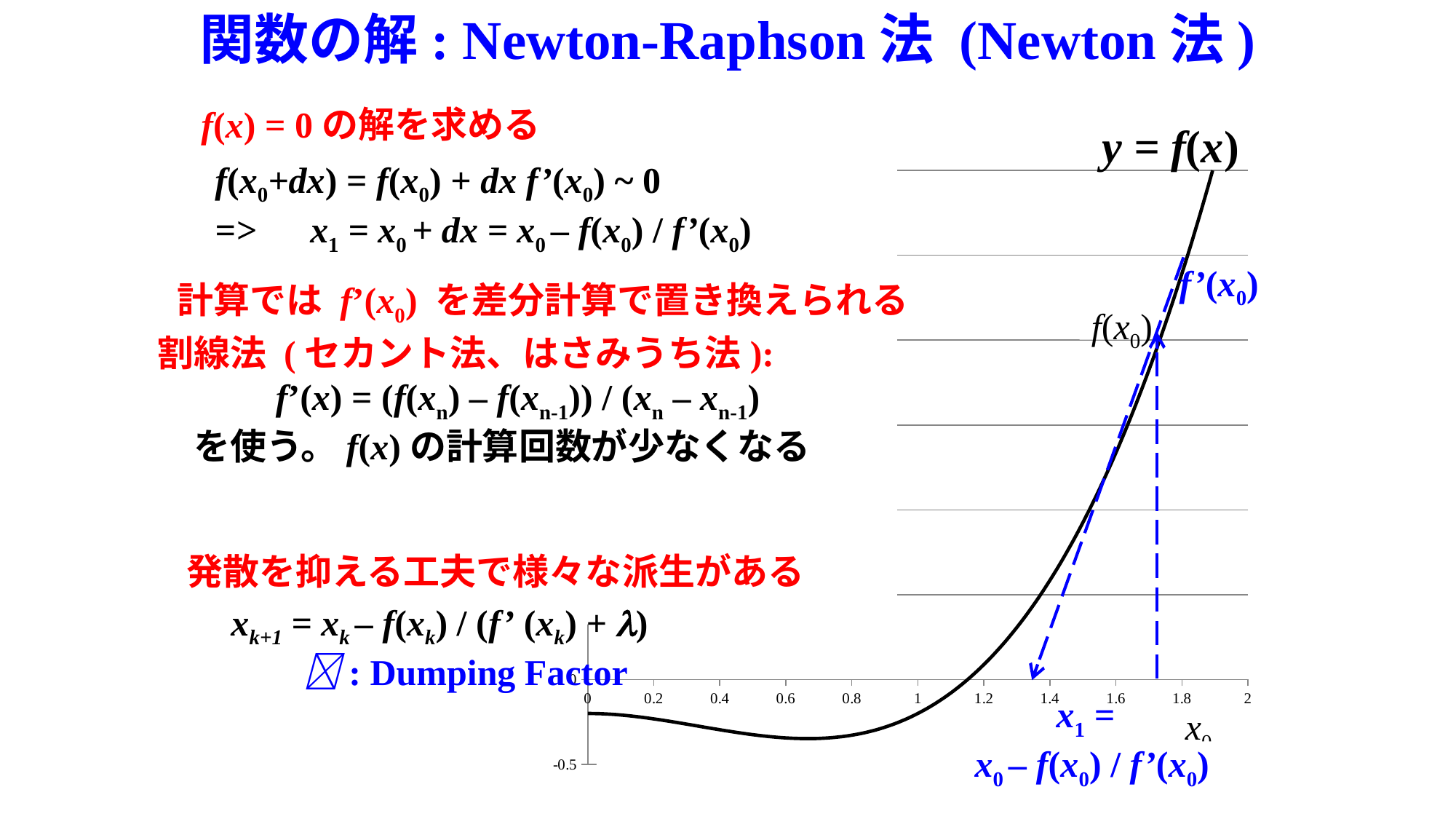
How many labelled tick marks are there on the x axis of the chart? 11 Does the curve rise or fall as x increases from 1.2 to 2? rises What label is written above the curve in the chart? y = f(x) Is the value of f(x) at x = 1.8 greater or less than 0? greater What is the lowest tick label shown on the y axis of the chart? -0.5 What kind of chart is shown on the right of the slide? line chart Is the value of f(x) at x = 0.6 greater or less than -0.5? greater What is the largest tick label on the x axis of the chart? 2 What is the spacing between consecutive x-axis tick labels on the chart? 0.2 Does the curve rise or fall as x increases from 0 to 0.6? falls Is the value of f(x) at x = 0.6 greater or less than 0? less What colour are the dashed lines drawn on the chart? blue